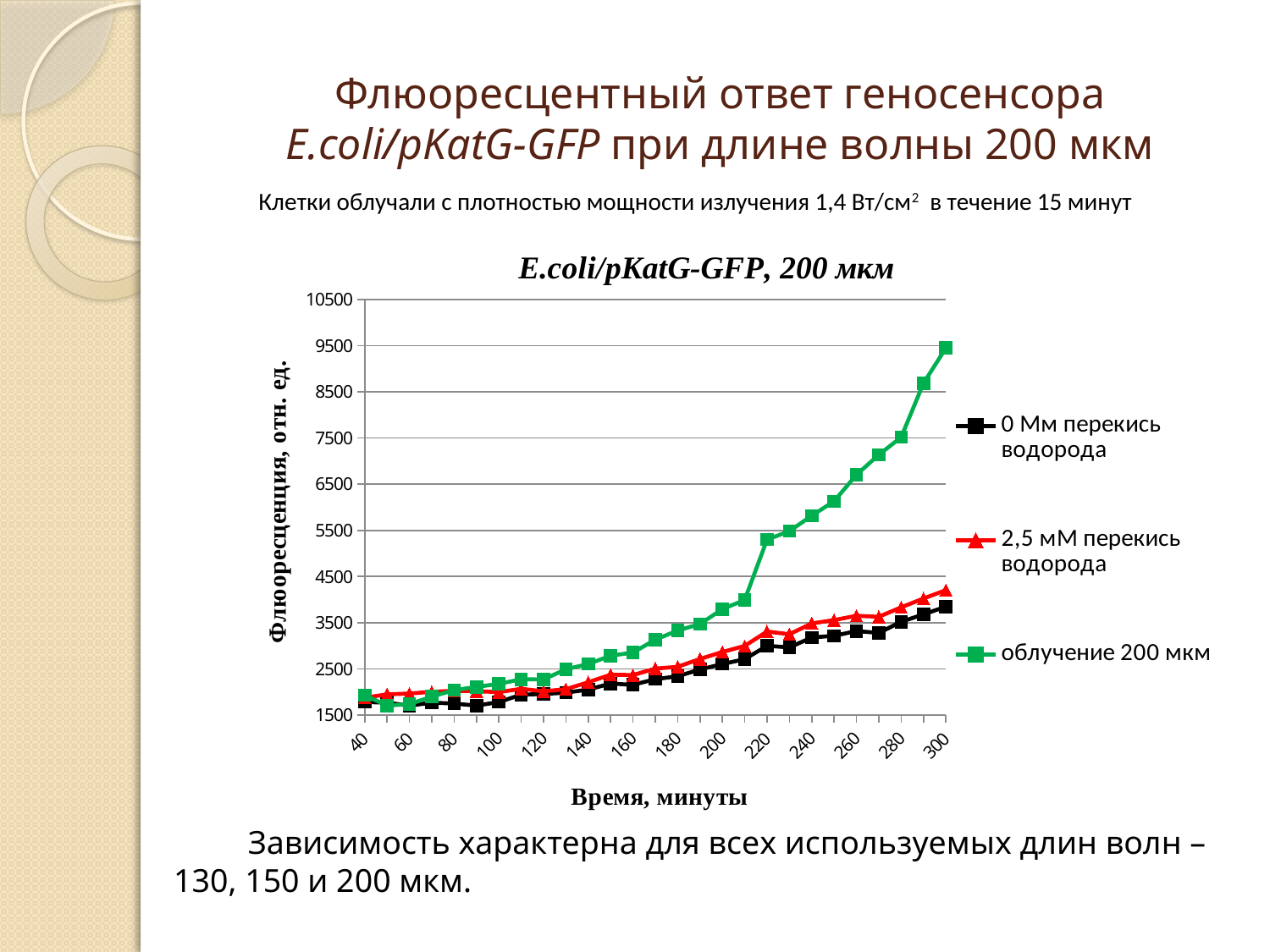
What is the title of the chart? E.coli/pKatG-GFP, 200 мкм Is the value for '0 Мм перекись водорода' at 300 minutes greater or less than 4500? less How many tick labels are shown on the x axis? 14 What kind of chart is shown on the slide? line chart Is the value for 'облучение 200 мкм' at 300 minutes greater or less than 8500? greater Is the value for '2,5 мМ перекись водорода' at 300 minutes greater or less than 3500? greater How many series does the legend list? 3 Which series reaches the highest fluorescence value on the chart? облучение 200 мкм What is the label of the x axis? Время, минуты At 260 minutes, which series has the larger value: 'облучение 200 мкм' or '2,5 мМ перекись водорода'? облучение 200 мкм Does the fluorescence for the 'облучение 200 мкм' series rise or fall as time increases? rise